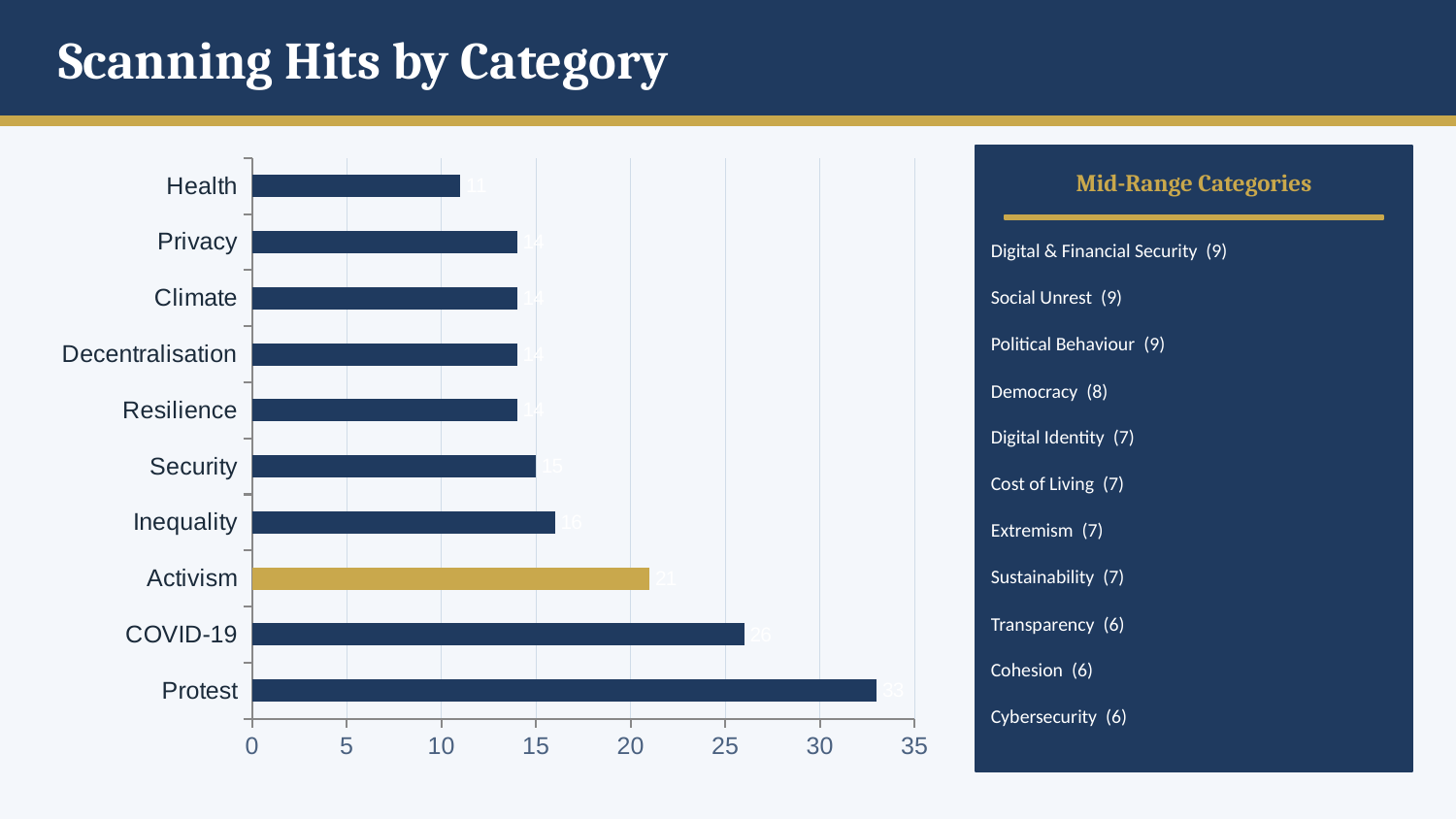
What is the value for Protest? 33 How many categories are plotted in the chart? 10 What is the value for Health? 11 What is the value for COVID-19? 26 Is the value for Privacy greater or less than 10? greater Which category has the highest number of scanning hits? Protest What is the difference between the values for Protest and COVID-19? 7 Which category's bar is coloured gold instead of dark blue? Activism Which category has the lowest number of scanning hits? Health What is the value for Activism? 21 What kind of chart is shown on the slide? bar chart Which has a larger value, Inequality or Security? Inequality